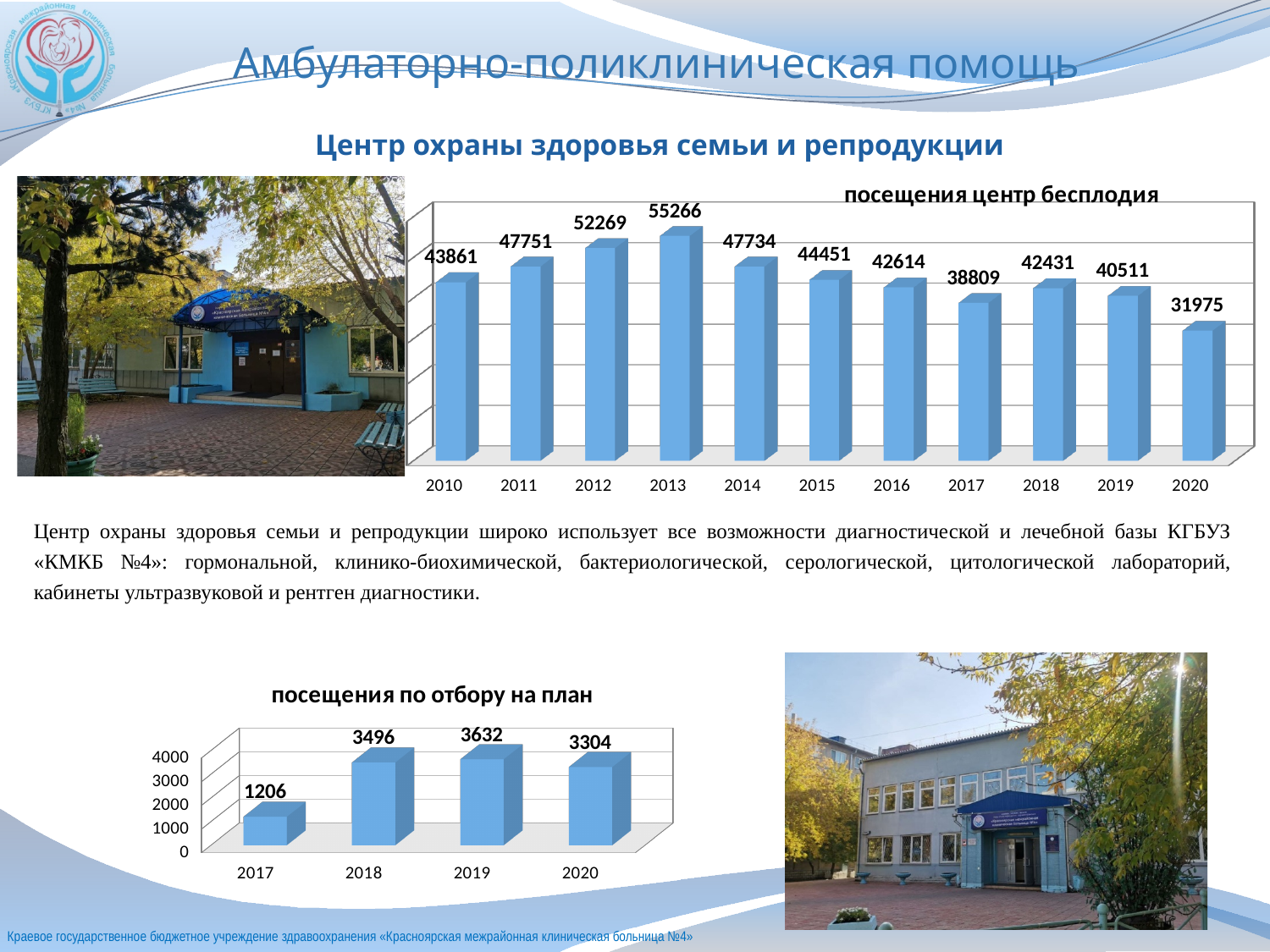
In the chart titled 'посещения центр бесплодия', what is the value for 2013? 55266 In the chart titled 'посещения центр бесплодия', which is larger, the value for 2017 or the value for 2018? 2018 In the chart titled 'посещения центр бесплодия', how many years are shown on the x axis? 11 In the chart titled 'посещения центр бесплодия', which year has the highest value? 2013 In the chart titled 'посещения центр бесплодия', what is the difference between the values for 2013 and 2020? 23291 In the chart titled 'посещения центр бесплодия', which year has the lowest value? 2020 In the chart titled 'посещения по отбору на план', what is the value for 2017? 1206 In the chart titled 'посещения центр бесплодия', what is the value for 2020? 31975 In the chart titled 'посещения по отбору на план', what is the difference between the values for 2019 and 2020? 328 In the chart titled 'посещения по отбору на план', which year has the highest value? 2019 What kind of chart is the chart titled 'посещения по отбору на план'? bar chart In the chart titled 'посещения по отбору на план', is the value for 2018 greater or less than 3000? greater